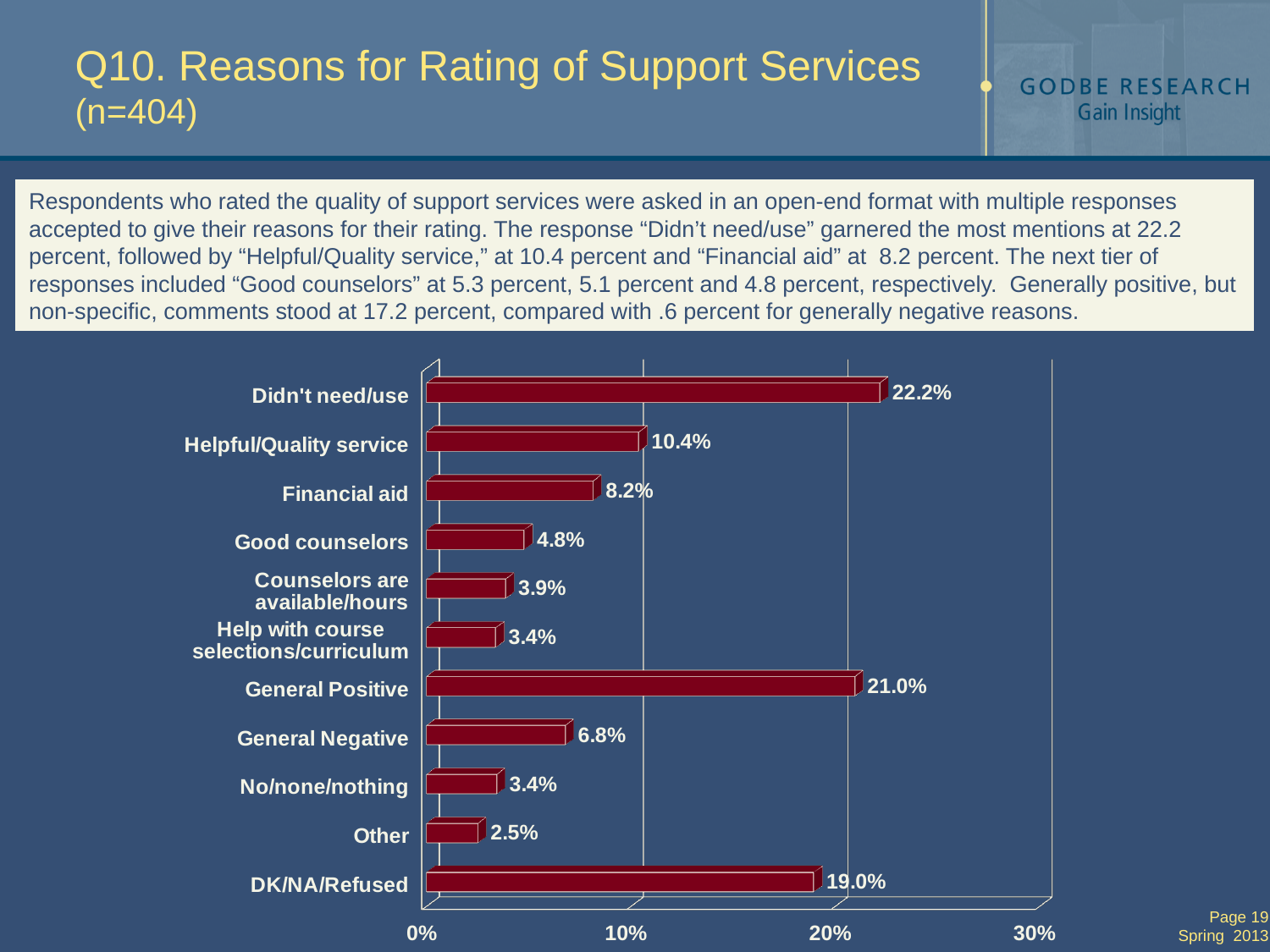
What is the value for Didn't need/use? 22.2% Which is larger, General Negative or Good counselors? General Negative What is the value for DK/NA/Refused? 19.0% Which category has the lowest value? Other What is the value for Counselors are available/hours? 3.9% Which category has the highest value? Didn't need/use What kind of chart is shown on the slide? Bar chart What is the value for General Positive? 21.0% Is the value for General Positive greater or less than 20%? greater How many categories are shown in the chart? 11 What is the highest value shown on the x axis? 30% What is the difference between Helpful/Quality service and Financial aid? 2.2%